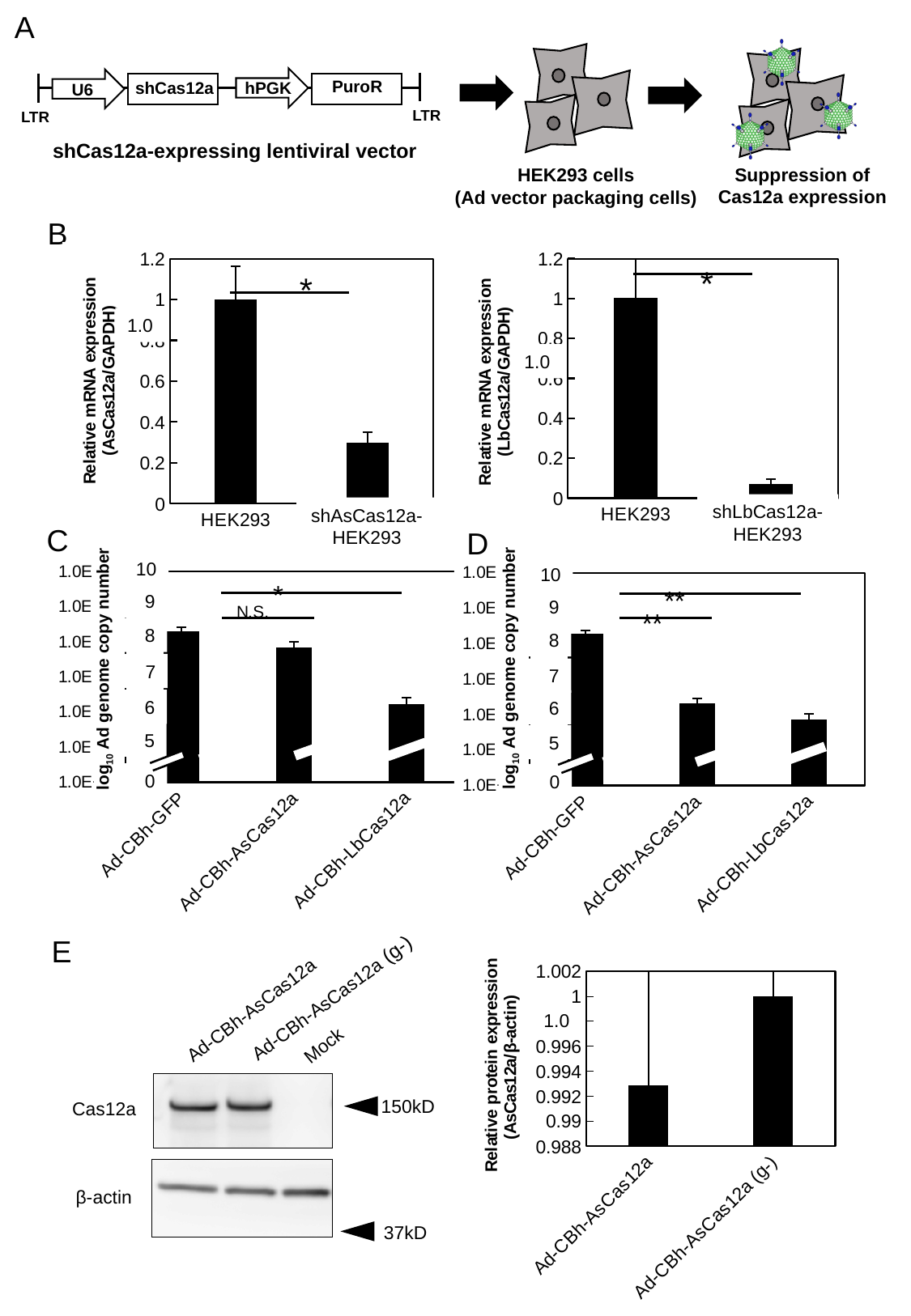
In the right chart of panel B (LbCas12a mRNA expression), which category has the lowest relative mRNA expression? shLbCas12a-HEK293 In the chart of panel C, is the value for Ad-CBh-LbCas12a greater or less than 7? less In the left chart of panel B (AsCas12a mRNA expression), is the value for shAsCas12a-HEK293 greater or less than 0.4? less In the chart of panel D, which category has the lowest log10 Ad genome copy number? Ad-CBh-LbCas12a In the left chart of panel B (AsCas12a mRNA expression), what kind of chart is shown? bar chart In the bar chart of panel E (relative protein expression), which is larger, the value for Ad-CBh-AsCas12a or the value for Ad-CBh-AsCas12a (g-)? Ad-CBh-AsCas12a (g-) In the chart of panel C, which category has the highest log10 Ad genome copy number? Ad-CBh-GFP In the chart of panel D, which is larger, the value for Ad-CBh-GFP or the value for Ad-CBh-AsCas12a? Ad-CBh-GFP In the chart of panel C, how many categories are plotted on the x axis? 3 In the left chart of panel B (AsCas12a mRNA expression), what is the relative mRNA expression value for HEK293? 1 In the left chart of panel B (AsCas12a mRNA expression), how many categories are plotted on the x axis? 2 In the right chart of panel B (LbCas12a mRNA expression), is the value for shLbCas12a-HEK293 greater or less than 0.2? less